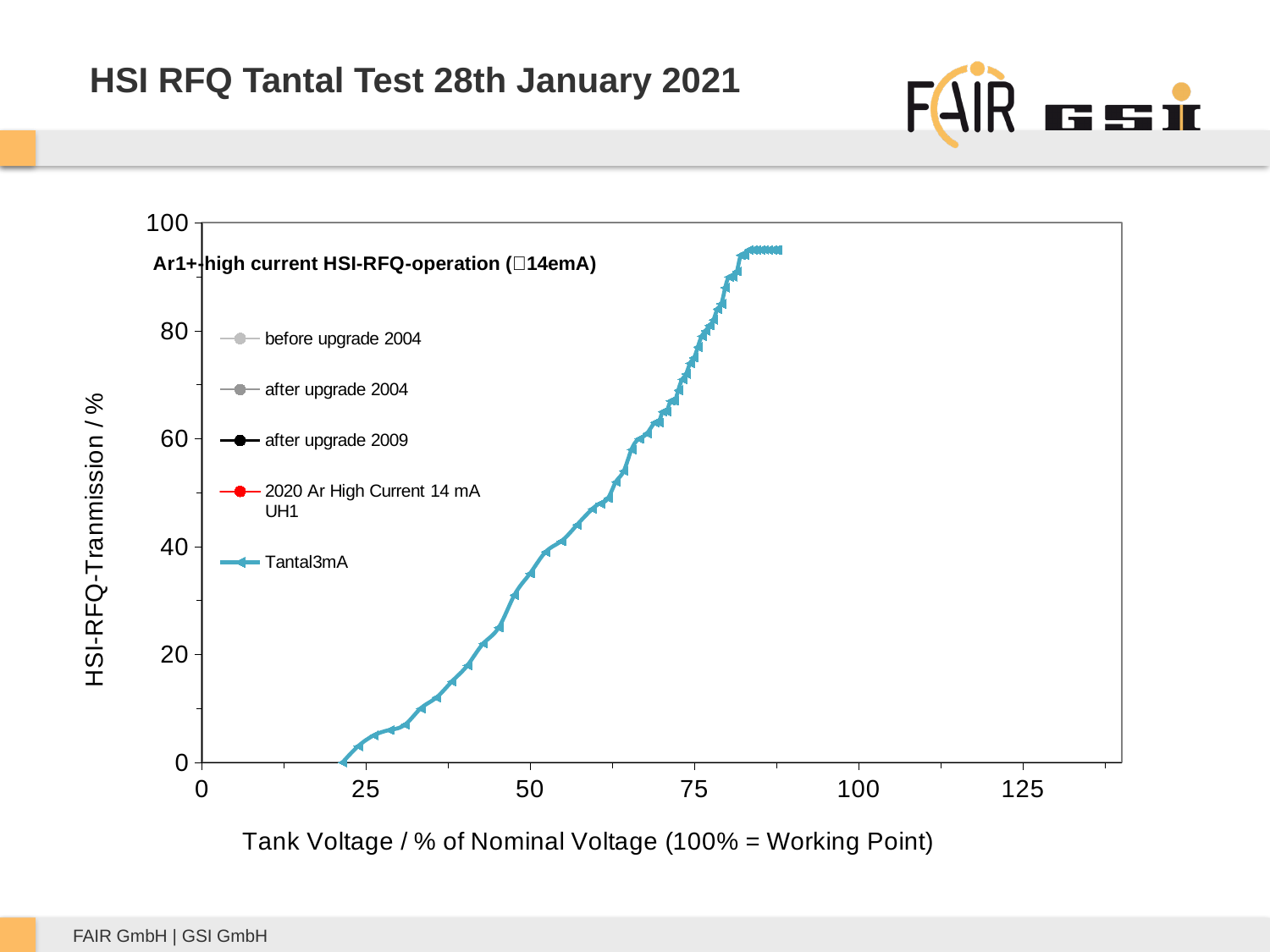
Is the Tantal3mA transmission at a tank voltage of 25% greater or less than 20? less Which series is actually plotted as a visible curve on the chart? Tantal3mA Does the Tantal3mA transmission rise or fall as the tank voltage increases along the x axis? rise Is the Tantal3mA transmission at a tank voltage of 50% greater or less than 40? less Is the highest Tantal3mA transmission reached on the chart greater or less than 80? greater What is the label of the y axis? HSI-RFQ-Tranmission / % What is the label of the x axis? Tank Voltage / % of Nominal Voltage (100% = Working Point) How many series does the legend list? 5 What kind of chart is shown on the slide? line chart